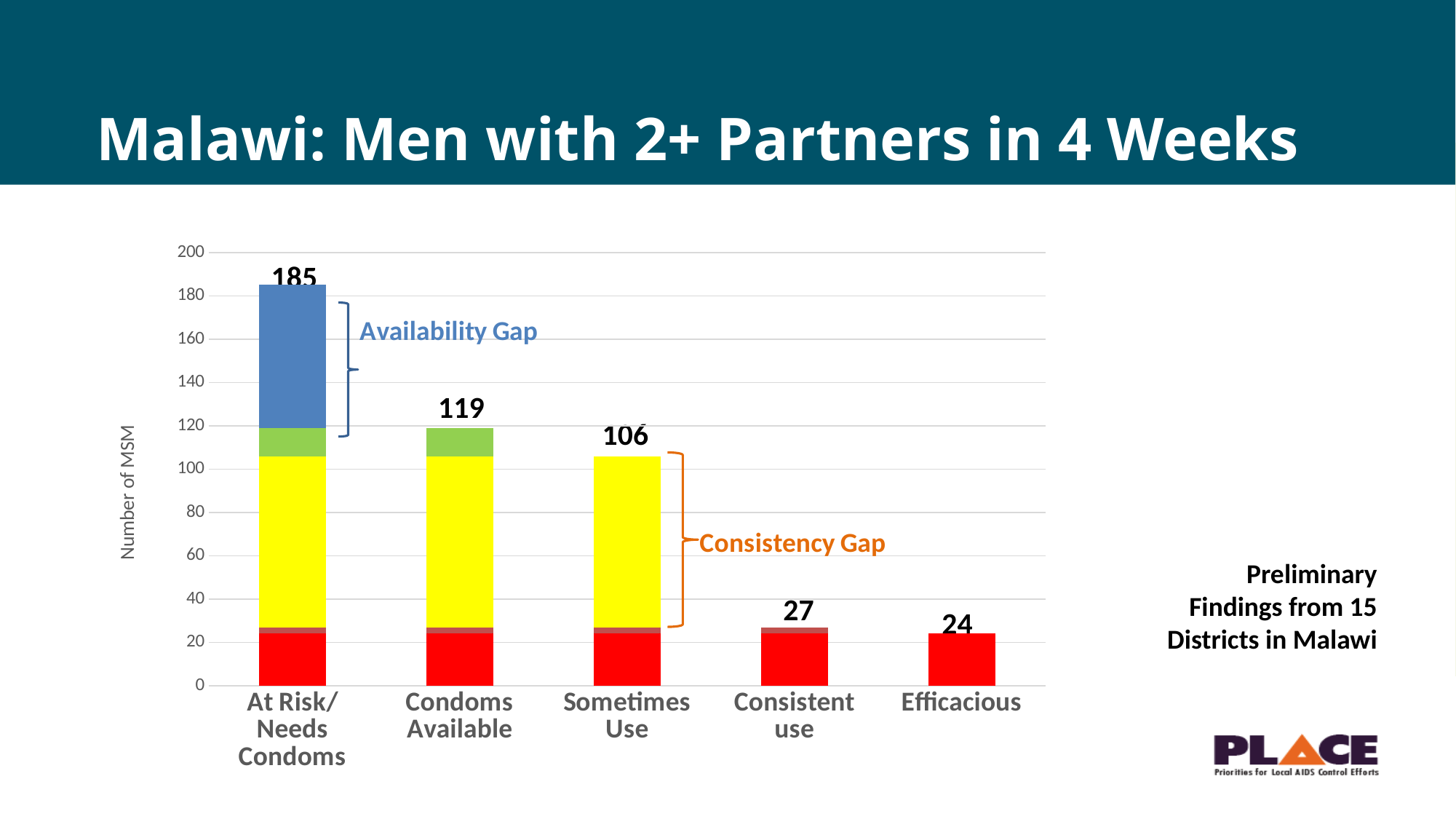
Which is larger, the Consistent use total or the Efficacious total? Consistent use Which category has the lowest total? Efficacious What is the total value shown for the At Risk/Needs Condoms bar? 185 Is the total for Sometimes Use greater or less than 100? greater How many categories are shown on the x axis? 5 Which category has the highest total? At Risk/Needs Condoms What is the label on the vertical axis of the chart? Number of MSM What is the value shown for the Efficacious bar? 24 What is the total value shown for the Condoms Available bar? 119 What kind of chart is shown on the slide? Stacked bar chart What is the difference between the At Risk/Needs Condoms total and the Condoms Available total? 66 What is the total value shown for the Sometimes Use bar? 106